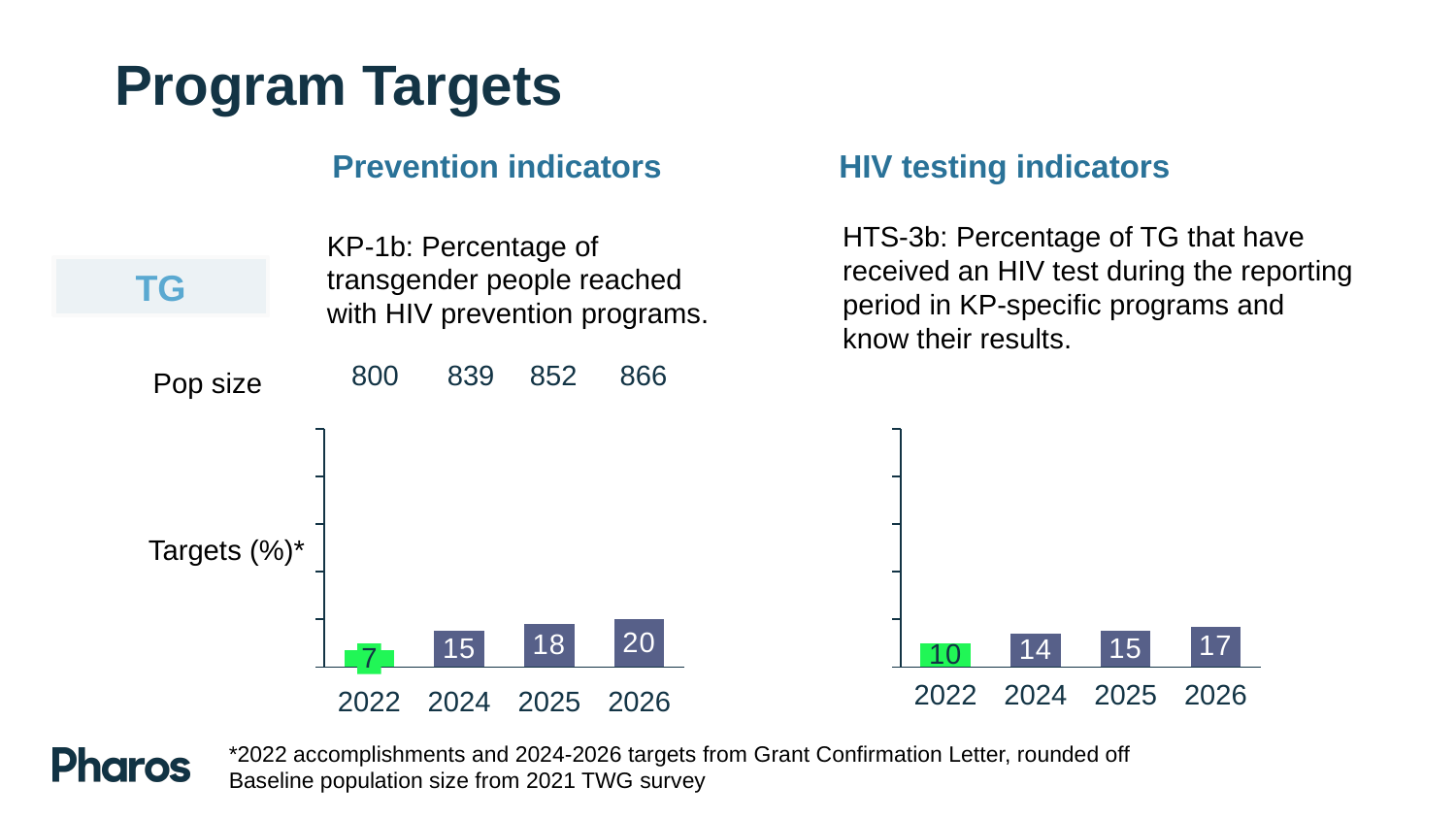
Which is larger: the 2025 value in the Prevention indicators chart or the 2025 value in the HIV testing indicators chart? Prevention indicators (18) How many years are shown on the x axis of the HIV testing indicators chart (HTS-3b)? 4 In the Prevention indicators chart (KP-1b), which year has the lowest value? 2022 In the Prevention indicators chart (KP-1b), what is the target value for 2026? 20 In the Prevention indicators chart (KP-1b), what is the value for 2022? 7 In the Prevention indicators chart (KP-1b), what is the difference between the 2026 and 2022 values? 13 In the HIV testing indicators chart (HTS-3b), which year has the highest value? 2026 In the HIV testing indicators chart (HTS-3b), what is the value for 2026? 17 In the HIV testing indicators chart (HTS-3b), what is the difference between the 2025 and 2024 values? 1 What type of chart is used for the Prevention indicators (KP-1b) targets? Bar chart In the Prevention indicators chart (KP-1b), do the values rise or fall from 2022 to 2026? Rise In the HIV testing indicators chart (HTS-3b), what is the value for 2024? 14